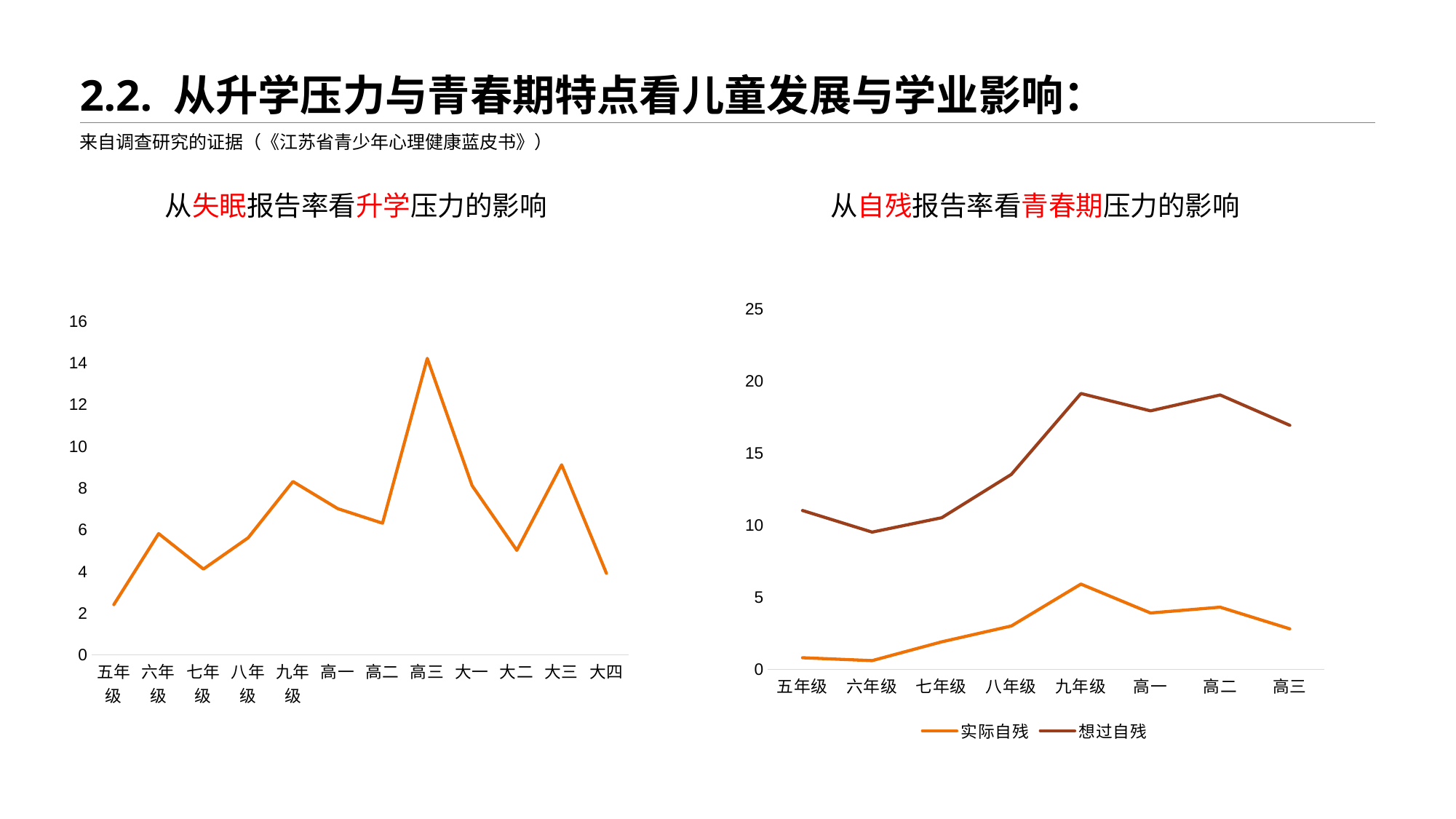
In the right chart (从自残报告率看青春期压力的影响), what are the two series named in the legend? 实际自残 and 想过自残 In the right chart (从自残报告率看青春期压力的影响), which grade has the highest value for 实际自残? 九年级 In the left chart (从失眠报告率看升学压力的影响), which grade has the highest insomnia report rate? 高三 In the left chart (从失眠报告率看升学压力的影响), which has a higher value, 九年级 or 大二? 九年级 In the left chart (从失眠报告率看升学压力的影响), is the value for 高三 greater or less than 12? greater In the left chart (从失眠报告率看升学压力的影响), which grade has the lowest insomnia report rate? 五年级 In the left chart (从失眠报告率看升学压力的影响), how many grade categories are shown on the x axis? 12 In the right chart (从自残报告率看青春期压力的影响), how many grade categories are shown on the x axis? 8 What kind of chart is the left chart titled 从失眠报告率看升学压力的影响? line chart In the left chart (从失眠报告率看升学压力的影响), is the value for 大四 greater or less than 6? less In the right chart (从自残报告率看青春期压力的影响), is the value of 想过自残 for 九年级 greater or less than 15? greater How many series does the legend of the right chart (从自残报告率看青春期压力的影响) list? 2